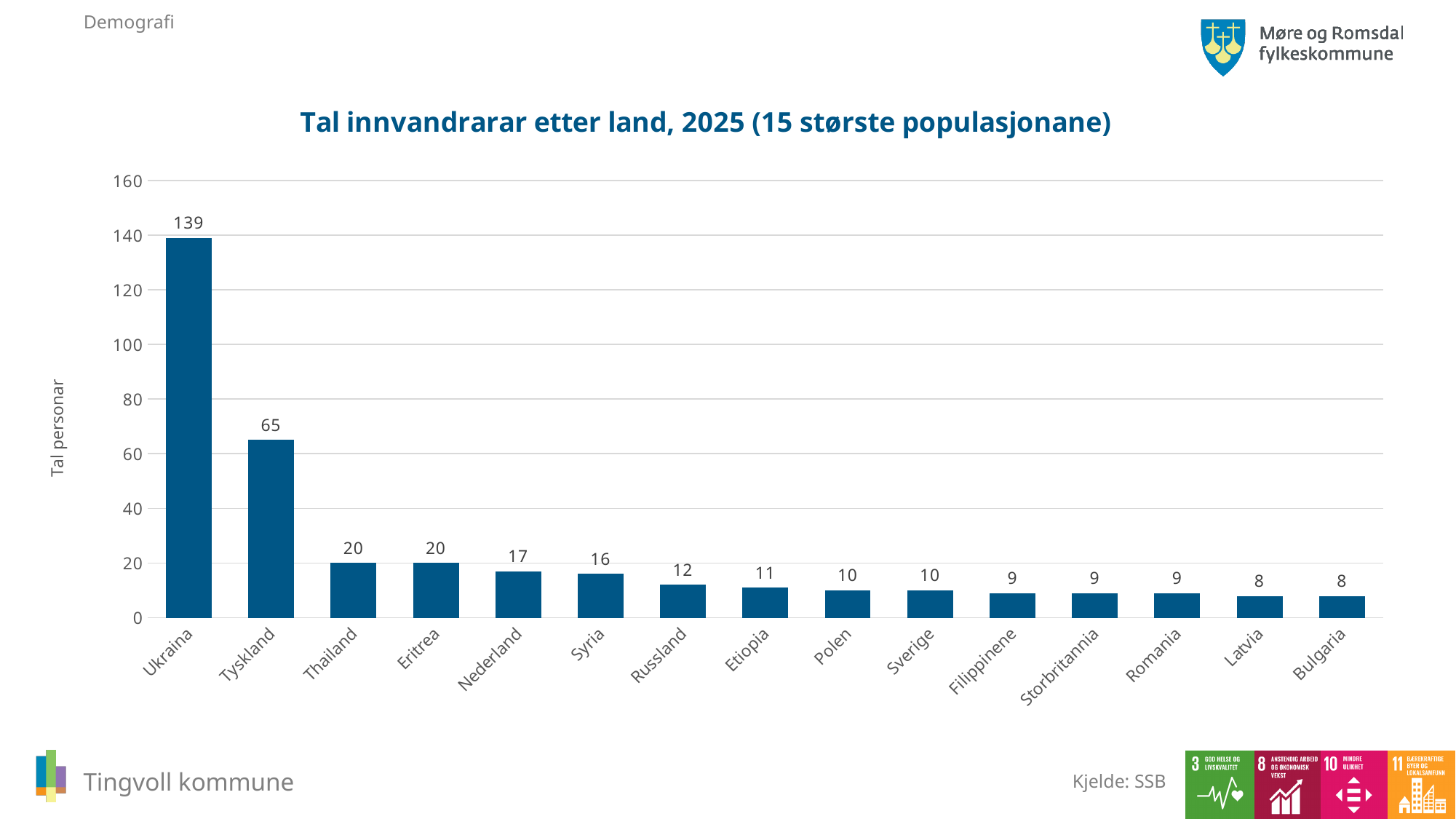
How many countries are shown on the chart? 15 Which is larger, the value for Etiopia or the value for Polen? Etiopia What is the value for Nederland? 17 What is the difference between the values for Thailand and Syria? 4 Is the value for Tyskland greater or less than 60? greater Which country has the highest value? Ukraina What is the value for Ukraina? 139 What is the title of the chart? Tal innvandrarar etter land, 2025 (15 største populasjonane) What is the difference between the values for Ukraina and Tyskland? 74 What is the value for Tyskland? 65 What is the value for Russland? 12 What kind of chart is this? bar chart